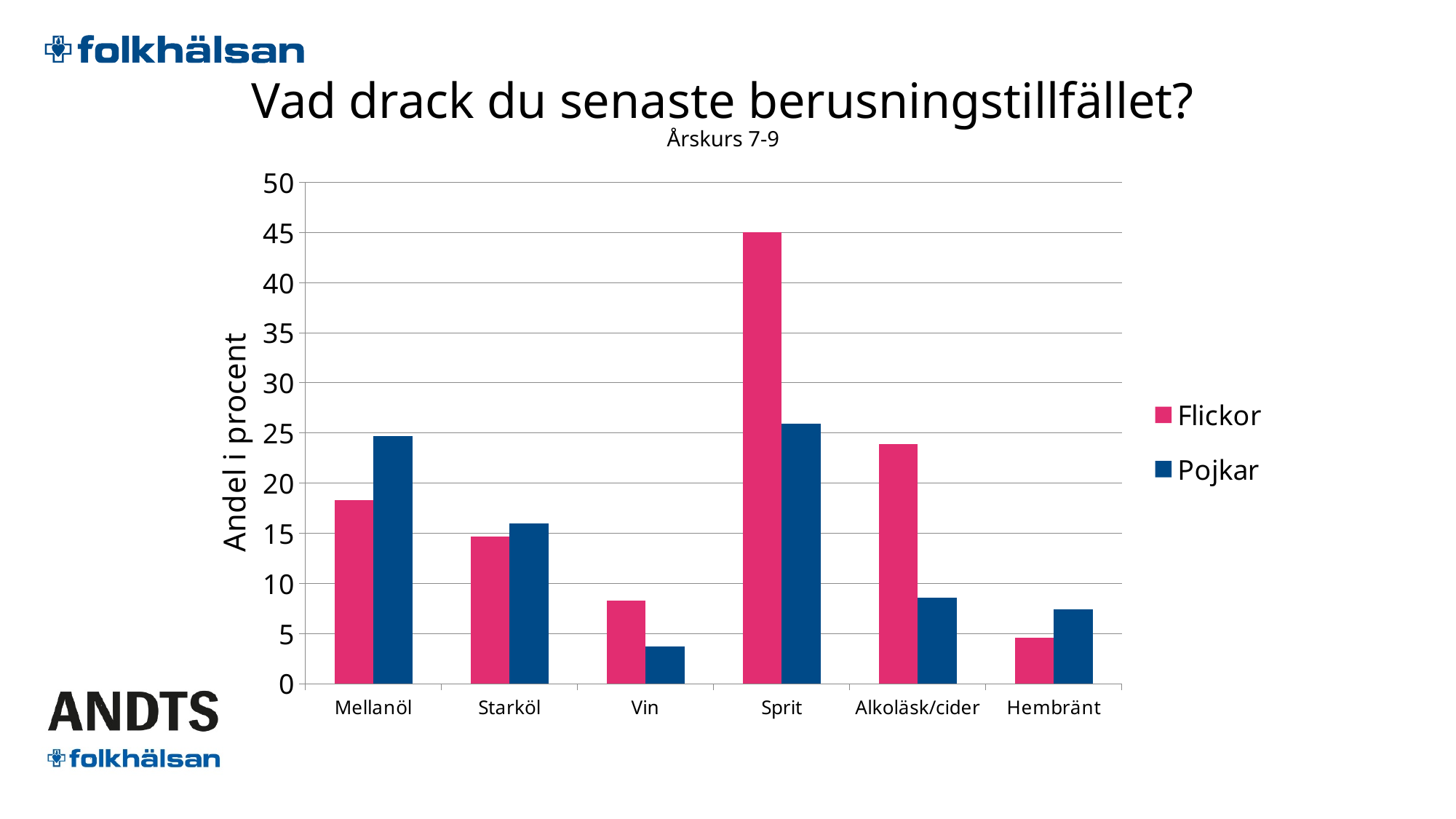
Is the value for Pojkar in Hembränt greater or less than 10? less How many series does the legend list? 2 What kind of chart is shown on the slide? bar chart How many categories are shown on the x axis? 6 For Vin, which series has the larger value, Flickor or Pojkar? Flickor For Mellanöl, which series has the larger value, Flickor or Pojkar? Pojkar Which category has the lowest value for Pojkar? Vin Which category has the lowest value for Flickor? Hembränt What is the label of the y axis? Andel i procent Which category has the highest value for Flickor? Sprit Is the value for Pojkar in Sprit greater or less than 20? greater Which category has the highest value for Pojkar? Sprit